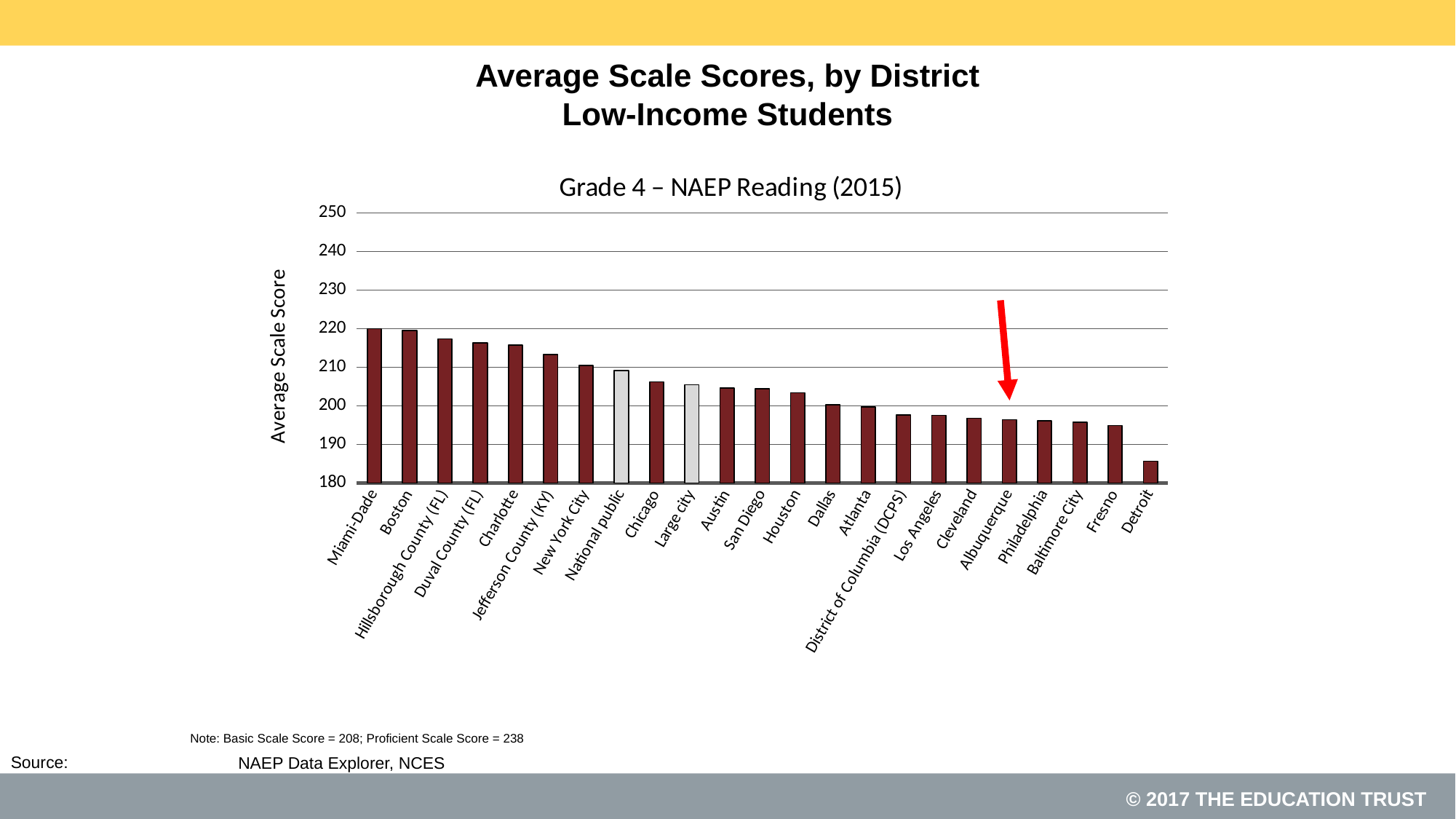
Is the value for Chicago greater or less than 200? greater Is the value for Detroit greater or less than 190? less Which has a higher average scale score, Houston or Charlotte? Charlotte Which category has the lowest average scale score? Detroit Which has a higher average scale score, Boston or Detroit? Boston What is the title of the chart? Grade 4 – NAEP Reading (2015) How many districts or categories are plotted along the x axis? 23 What kind of chart is shown on the slide? Bar chart Is the value for Fresno greater or less than 200? less Do the values generally rise or fall moving from left to right along the x axis? Fall